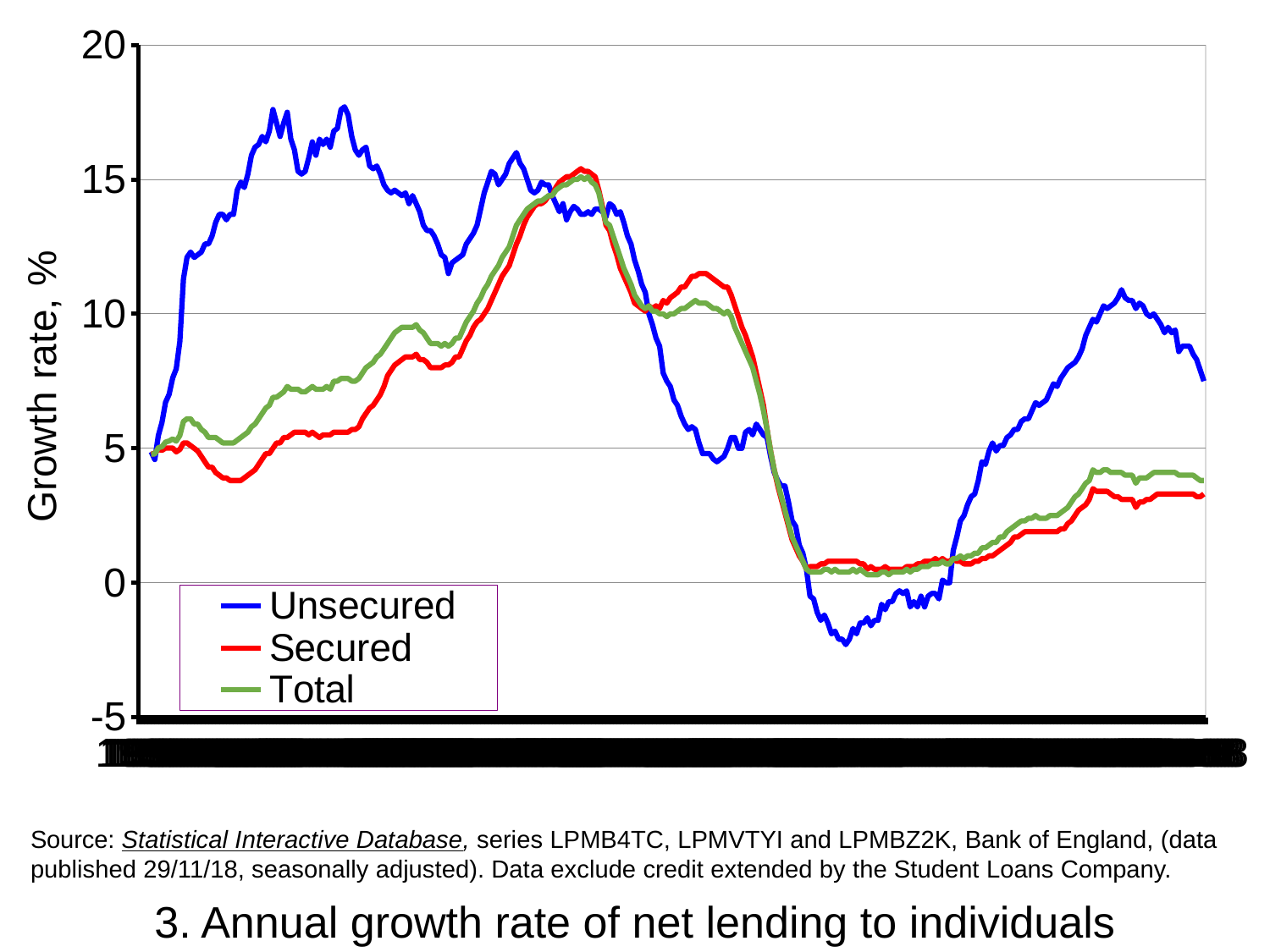
What is the title of the chart? 3. Annual growth rate of net lending to individuals Is the highest value reached by the Secured series greater or less than 10? greater Which series reaches the highest peak on the chart? Unsecured Is the highest value reached by the Unsecured series greater or less than 15? greater What kind of chart is shown on the slide? Line chart At the right-hand end of the chart, which is larger: the Unsecured value or the Secured value? Unsecured How many series does the legend list? 3 At the right-hand end of the chart, is the Total series greater or less than 5? less Which series falls to the lowest value on the chart? Unsecured What is the label on the vertical axis? Growth rate, %